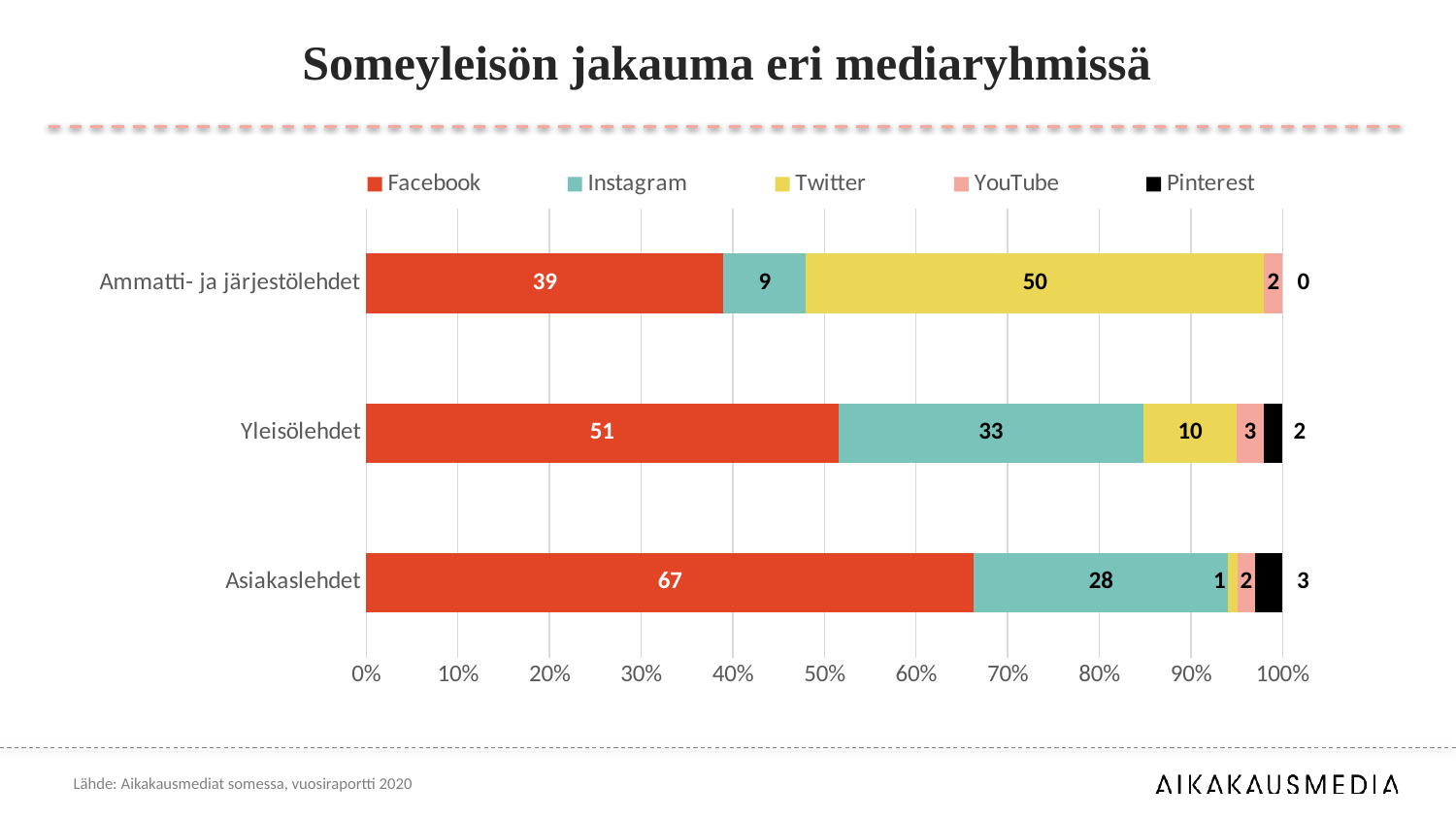
Which media group has the lowest Twitter value? Asiakaslehdet Which media group has the highest Facebook value? Asiakaslehdet Which is larger: the Instagram value for Yleisölehdet or the Instagram value for Ammatti- ja järjestölehdet? Yleisölehdet What is the title of the chart? Someyleisön jakauma eri mediaryhmissä What is the Facebook value for Yleisölehdet? 51 What is the Instagram value for Asiakaslehdet? 28 What is the difference between the Facebook values for Asiakaslehdet and Ammatti- ja järjestölehdet? 28 What is the Twitter value for Ammatti- ja järjestölehdet? 50 How many series does the legend list? 5 What is the Pinterest value for Ammatti- ja järjestölehdet? 0 How many media groups (categories) are shown in the chart? 3 What kind of chart is shown on the slide? Stacked bar chart